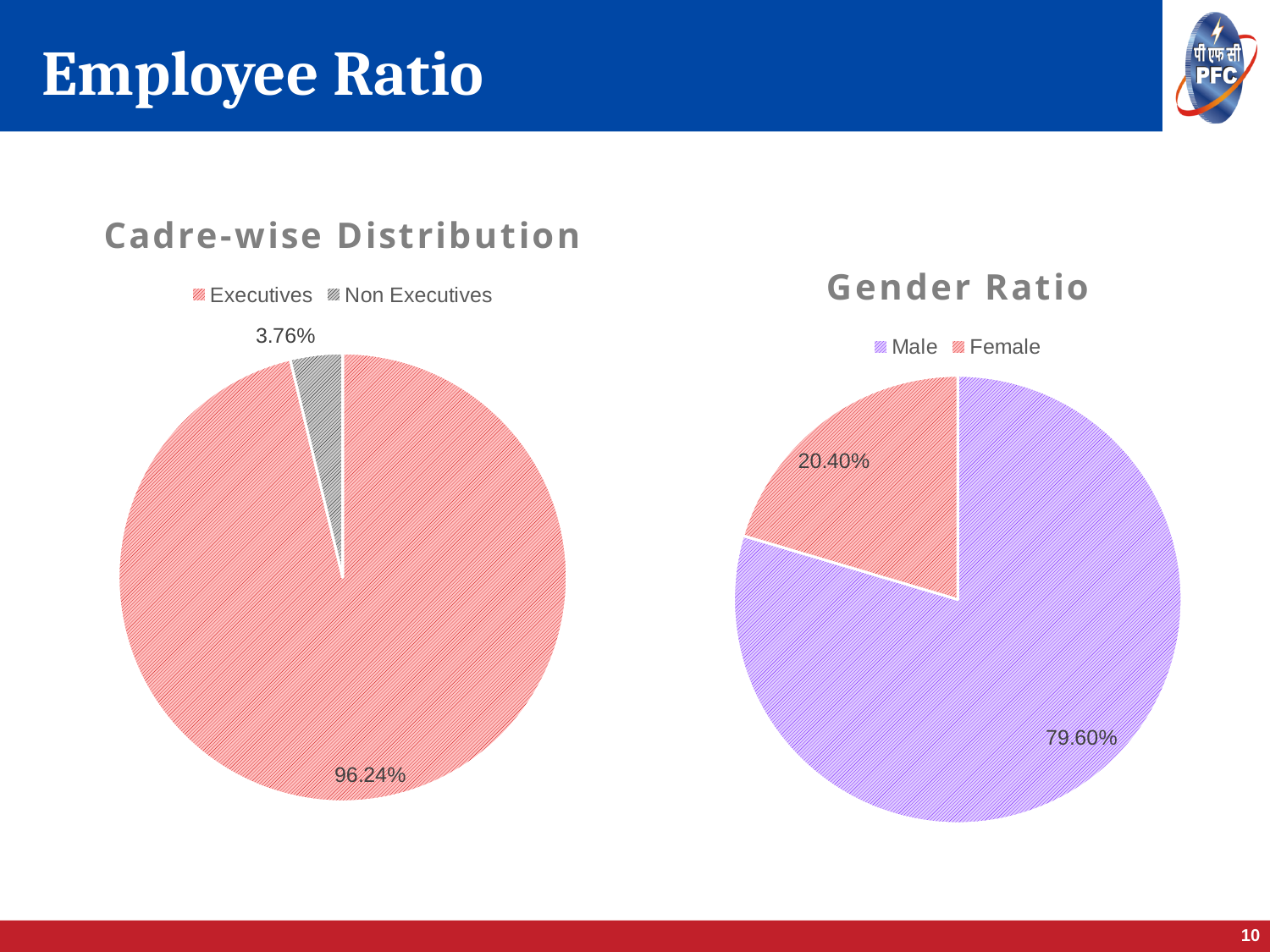
In the Cadre-wise Distribution chart, what share of employees are Non Executives? 3.76% How many categories does the Gender Ratio chart show? 2 What type of chart is the Cadre-wise Distribution chart? Pie chart In the Gender Ratio chart, what share of employees are Male? 79.60% In the Gender Ratio chart, what is the difference between the Male and Female shares? 59.20% In the Gender Ratio chart, what share of employees are Female? 20.40% What are the legend entries of the Cadre-wise Distribution chart? Executives, Non Executives In the Gender Ratio chart, which category has the smallest slice? Female In the Cadre-wise Distribution chart, which category has the largest slice? Executives In the Gender Ratio chart, which is larger, the Male share or the Female share? Male In the Cadre-wise Distribution chart, what is the difference between the Executives and Non Executives shares? 92.48%